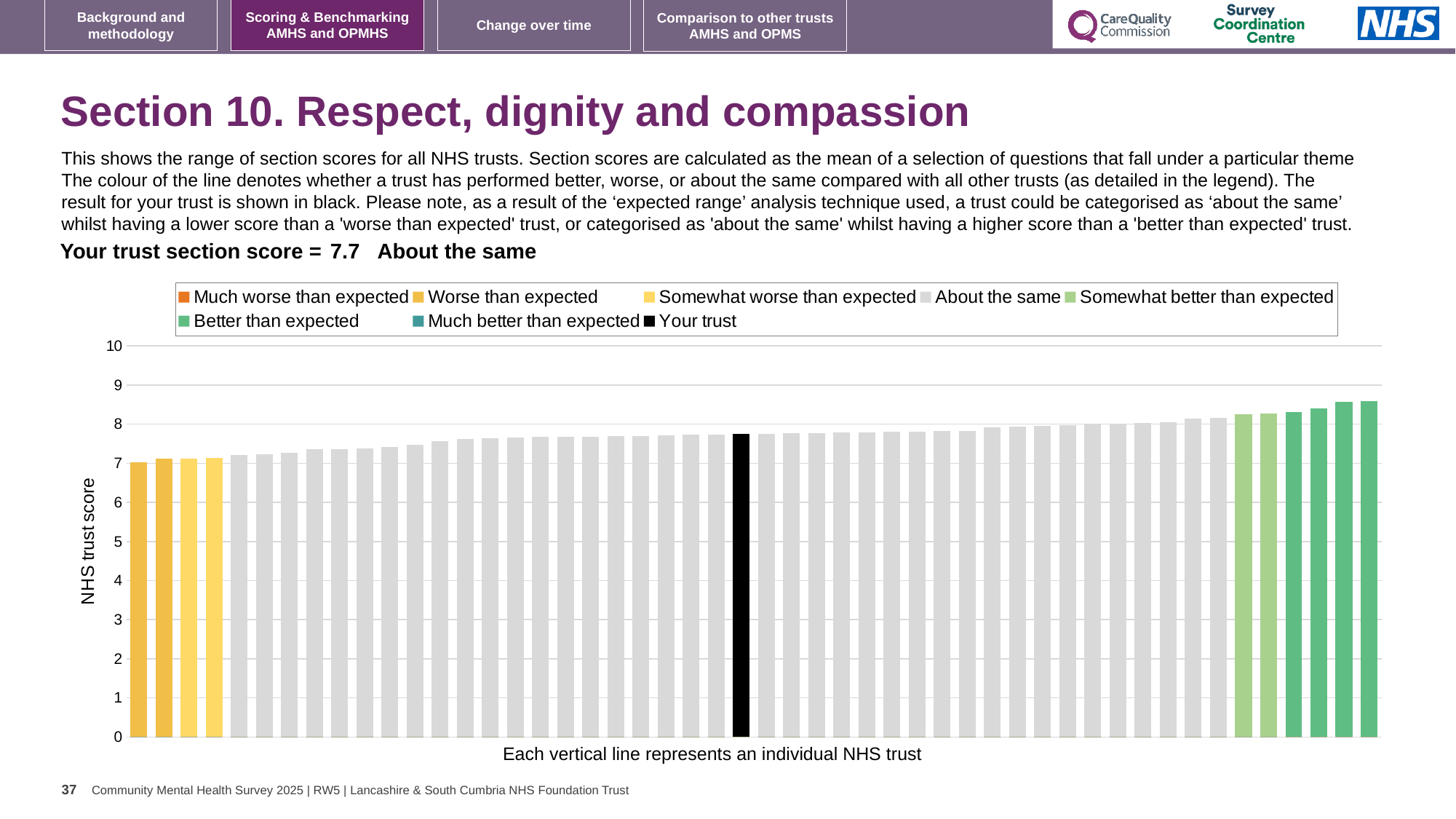
What is the highest value shown on the vertical axis of the chart? 10 How many entries does the chart legend list? 8 What kind of chart is shown on the slide? bar chart Is the value of the black 'Your trust' bar greater or less than 8? less Is the value of the shortest bar in the chart greater or less than 8? less Is the value of the tallest bar in the chart greater or less than 8? greater What colour is used for the 'Your trust' bar in the chart? black Do the bar values rise or fall from left to right across the chart? rise Which category is your trust placed in for this section? About the same What is the section score for your trust shown on the slide? 7.7 What is the label on the vertical axis of the chart? NHS trust score